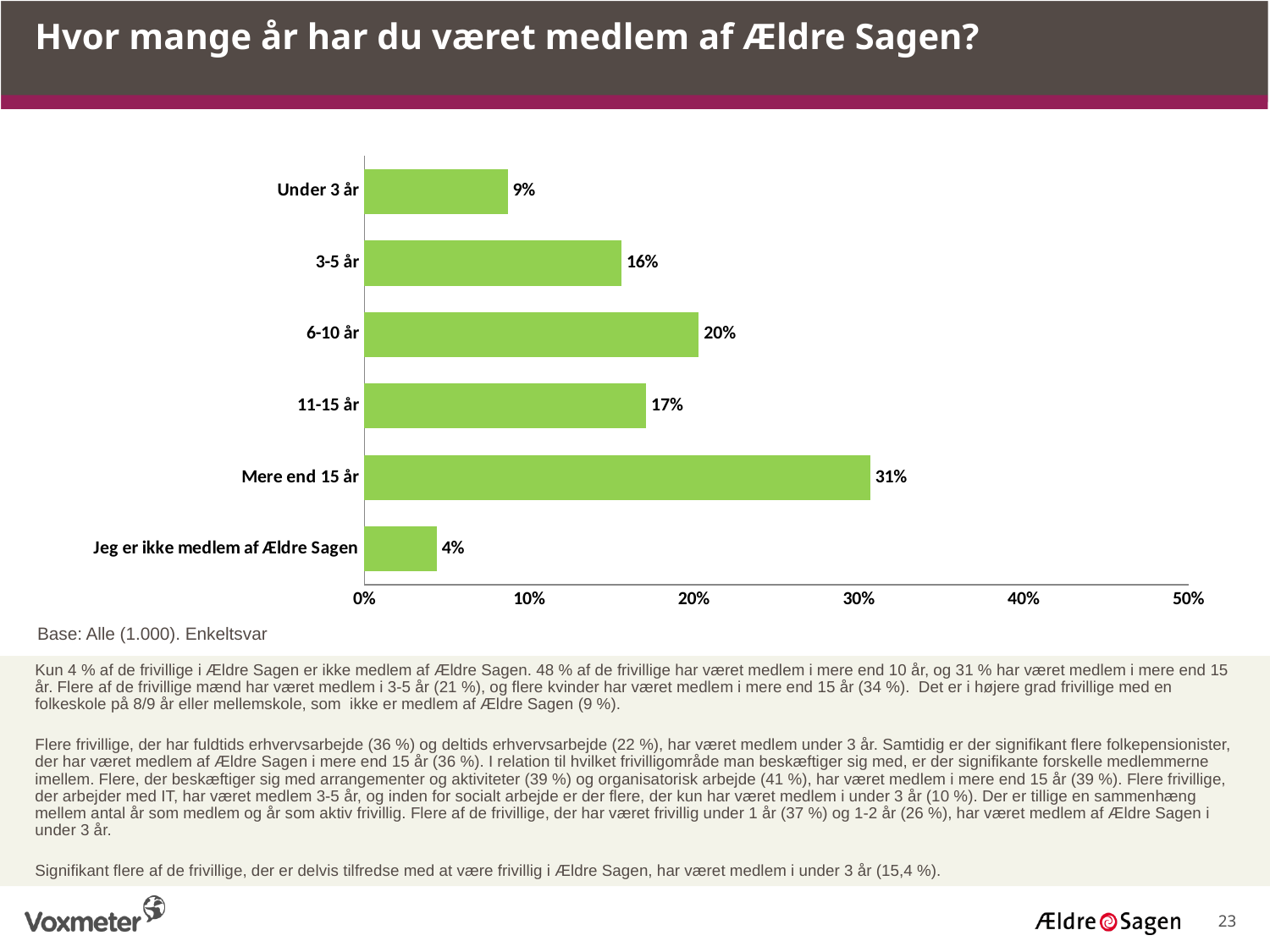
What is the value for "Under 3 år"? 9% What is the difference between the values for "Mere end 15 år" and "6-10 år"? 11% Which is larger, the value for "3-5 år" or the value for "11-15 år"? 11-15 år What is the value for "6-10 år"? 20% Which category has the highest value? Mere end 15 år Which category has the lowest value? Jeg er ikke medlem af Ældre Sagen How many categories are shown in the chart? 6 What kind of chart is shown on the slide? Bar chart What is the value for "Mere end 15 år"? 31% Is the value for "Mere end 15 år" greater or less than 30%? greater What is the title of the chart? Hvor mange år har du været medlem af Ældre Sagen? What is the maximum value shown on the x axis? 50%